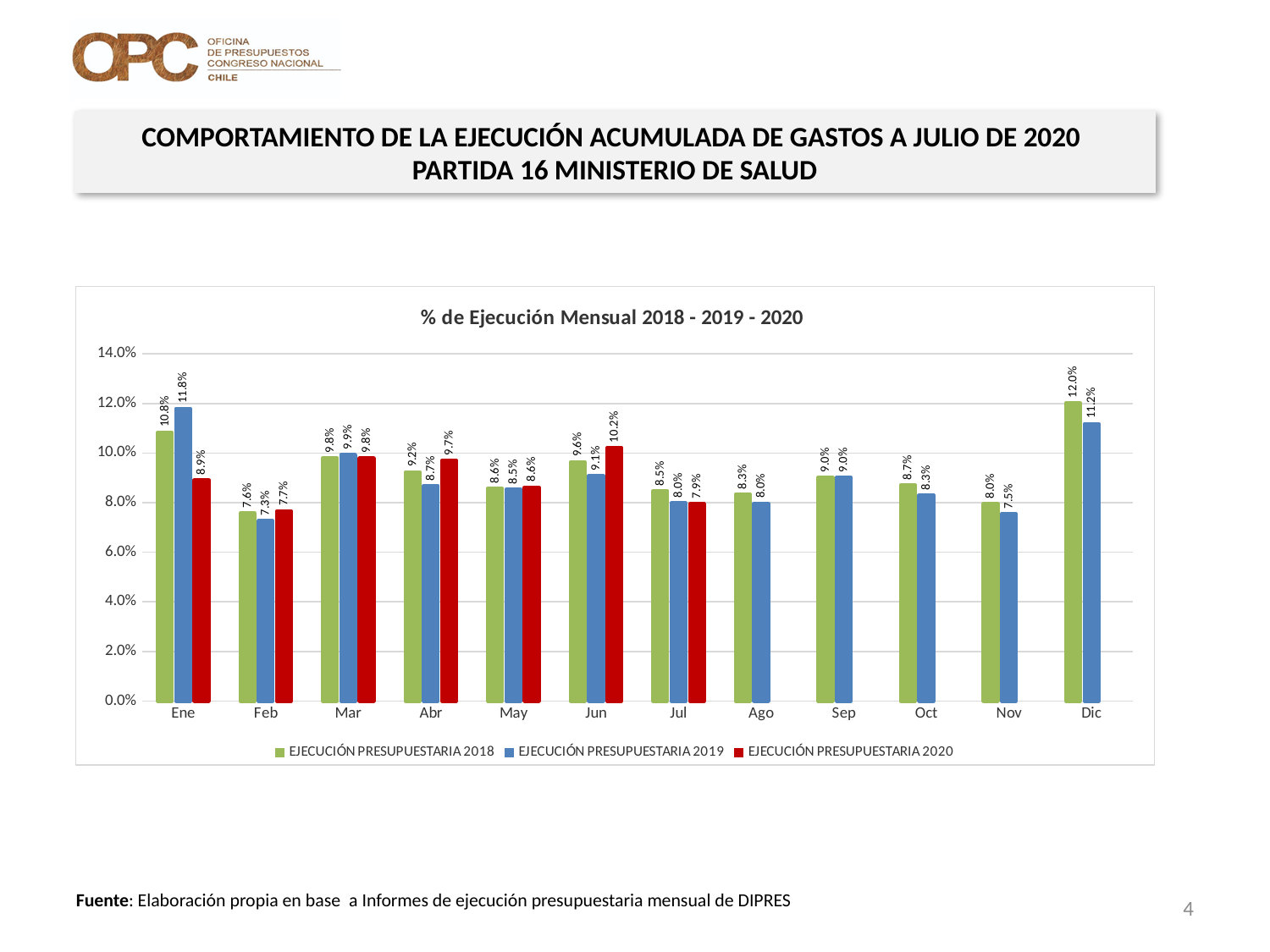
What is the difference between the 2019 and 2020 values in Ene? 2.9% In Abr, which is larger: the 2018 value or the 2020 value? 2020 value Which month has the highest value for EJECUCIÓN PRESUPUESTARIA 2020? Jun How many series does the legend list? 3 How many months are shown on the x axis? 12 What kind of chart is shown? Bar chart What is the title of the chart? % de Ejecución Mensual 2018 - 2019 - 2020 What is the value for EJECUCIÓN PRESUPUESTARIA 2019 in Ene? 11.8% Which month has the lowest value for EJECUCIÓN PRESUPUESTARIA 2019? Feb What is the value for EJECUCIÓN PRESUPUESTARIA 2018 in Dic? 12.0% Which colour represents EJECUCIÓN PRESUPUESTARIA 2020 in the chart? Red What is the value for EJECUCIÓN PRESUPUESTARIA 2020 in Jun? 10.2%